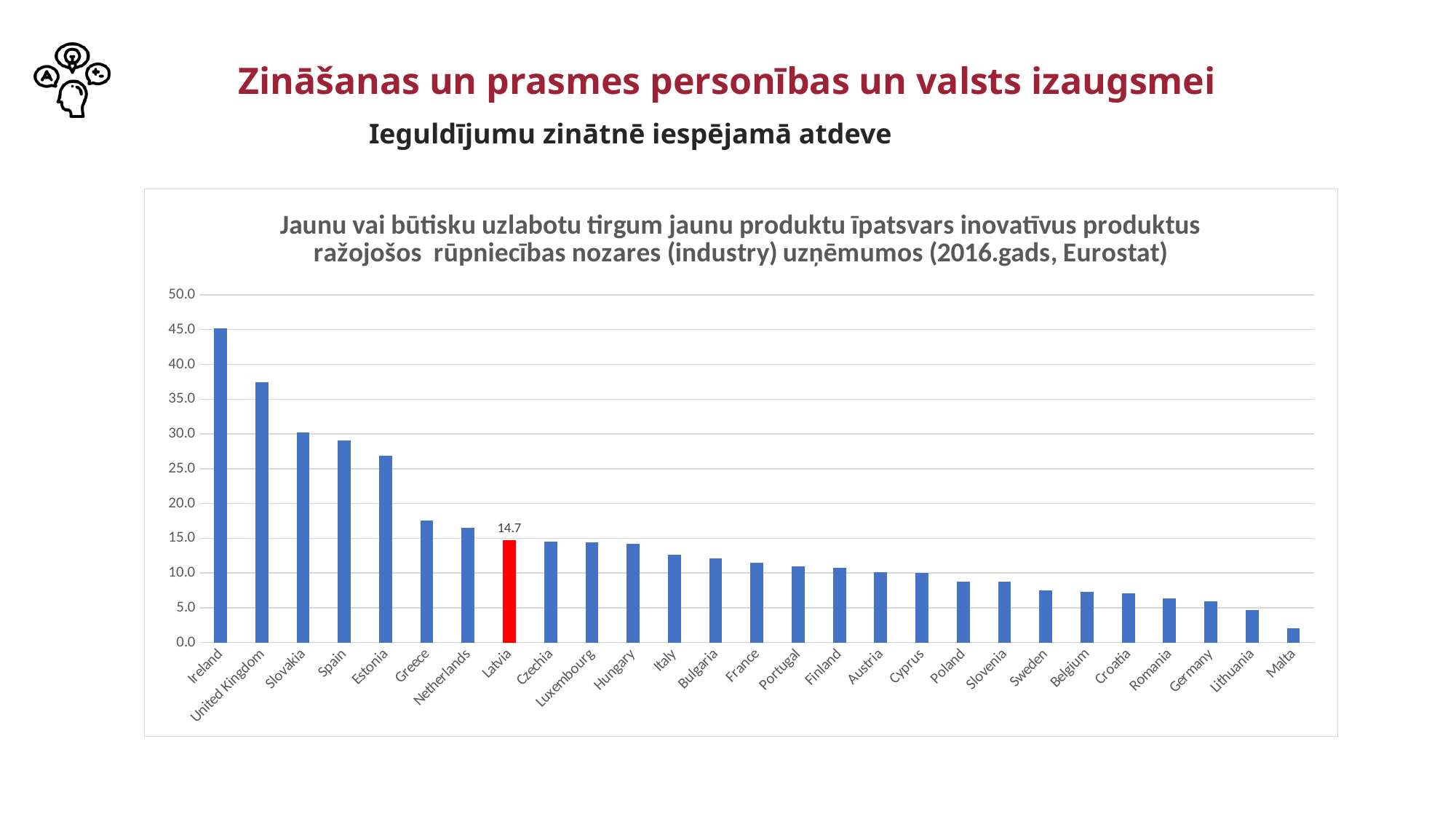
Do the values rise or fall from left to right along the x axis? fall How many countries are shown in the chart? 27 What is the value for Latvia? 14.7 Is the value for Germany greater or less than 10.0? less Which country has the highest value? Ireland What kind of chart is shown on the slide? bar chart Is the value for United Kingdom greater or less than 35.0? greater Which country's bar is coloured red? Latvia Is the value for Ireland greater or less than 40.0? greater Which has a larger value, Spain or Greece? Spain Which country has the lowest value? Malta Which has a larger value, Italy or Sweden? Italy